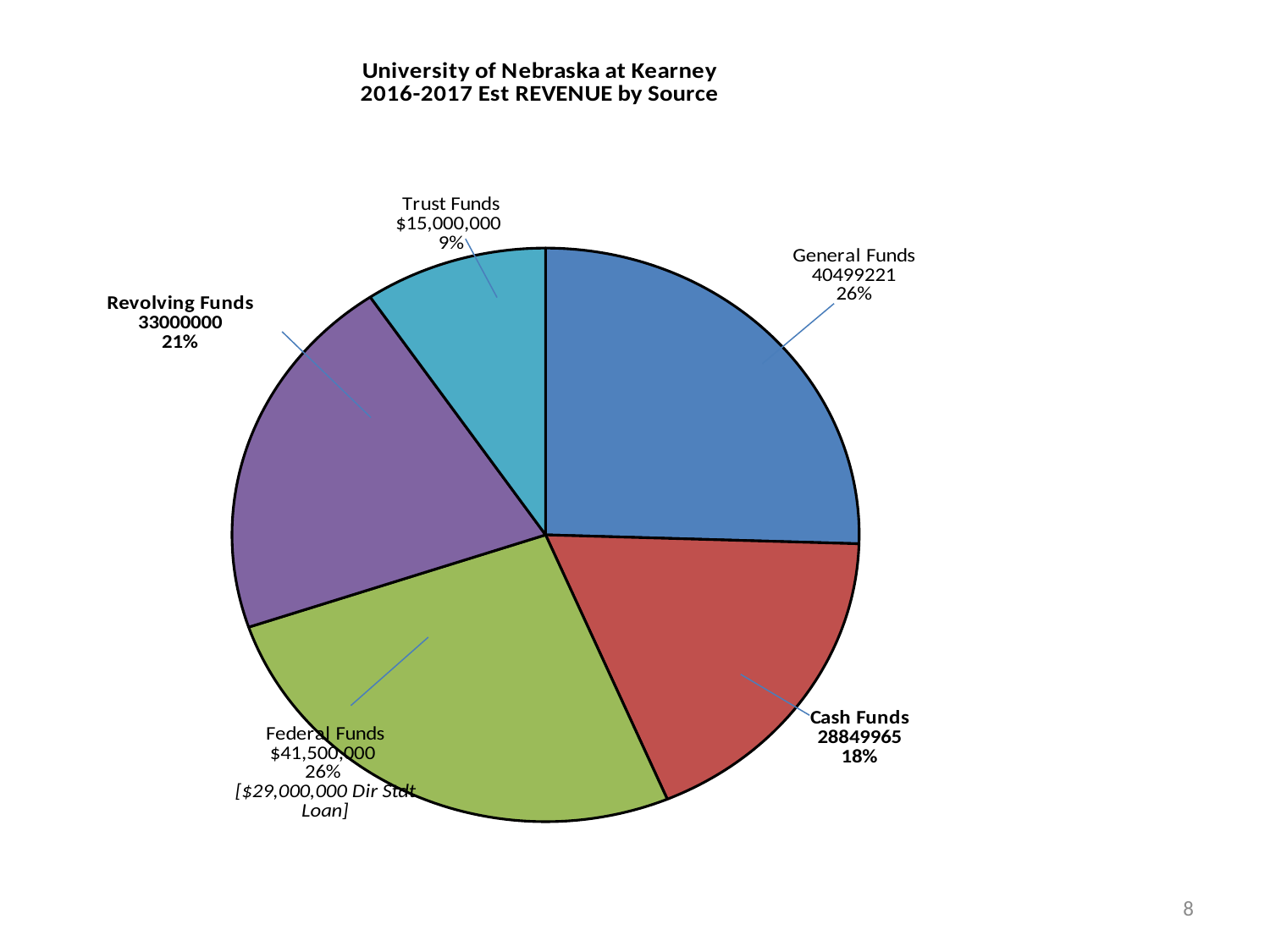
Which revenue source has the largest dollar value? Federal Funds Which revenue source has the smallest value? Trust Funds What is the value shown for Federal Funds? $41,500,000 What is the value shown for General Funds? 40499221 What percentage share of the pie is Trust Funds? 9% How many revenue sources are shown in the pie chart? 5 What is the difference between the Revolving Funds value and the Cash Funds value? 4150035 What is the value shown for Cash Funds? 28849965 What is the value shown for Revolving Funds? 33000000 What percentage share of the pie is Cash Funds? 18% Which is larger, Revolving Funds or Cash Funds? Revolving Funds What type of chart is shown on the slide? Pie chart